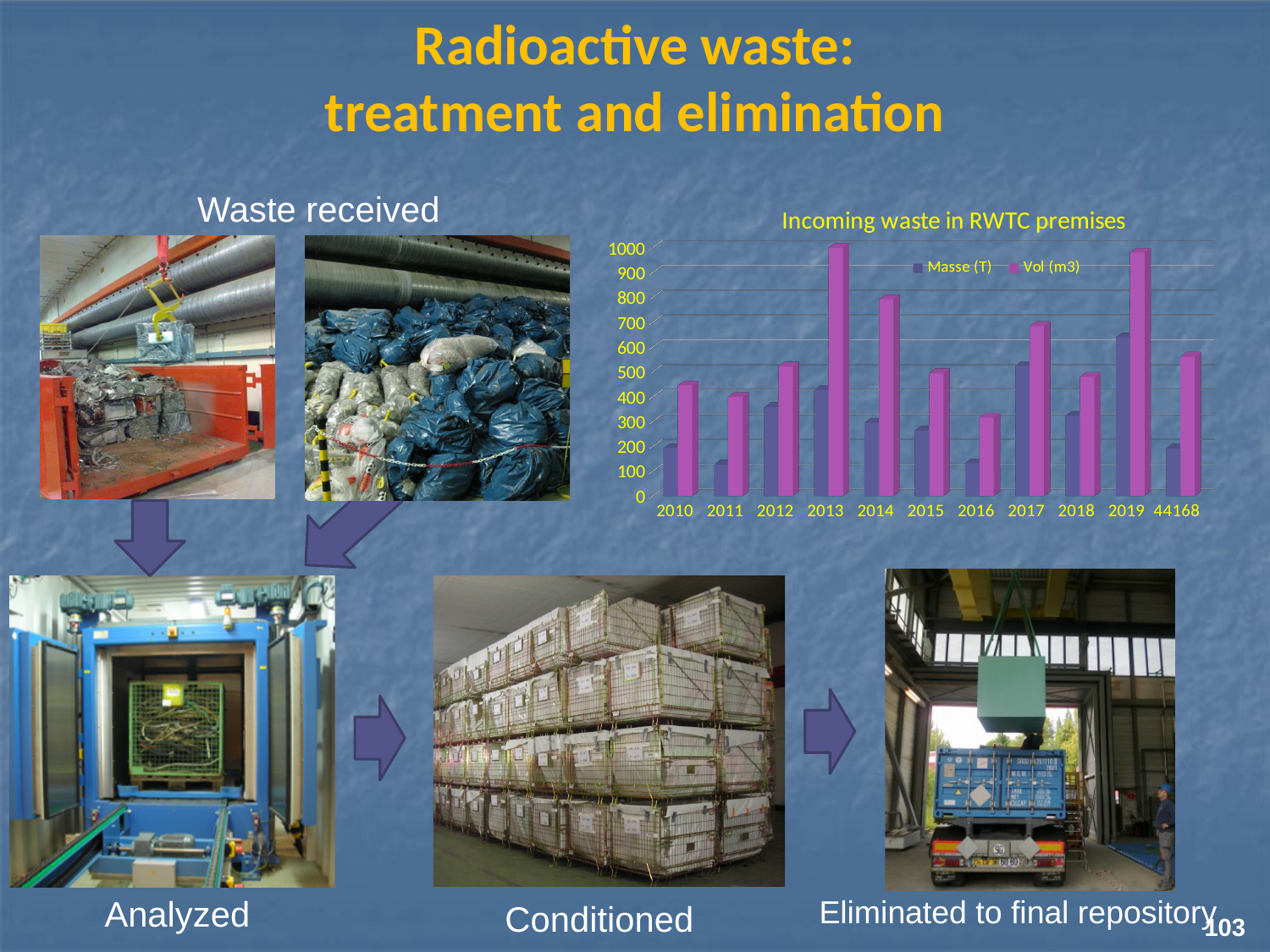
What kind of chart is shown on the slide? bar chart Is the Masse (T) value for 2011 greater or less than 200? less Which year has the lowest Vol (m3) value? 2016 Which is larger, the Vol (m3) value for 2014 or for 2017? 2014 How many series does the chart legend list? 2 Which series is shown in magenta in the chart? Vol (m3) Is the Vol (m3) value for 2016 greater or less than 400? less Which year has the highest Masse (T) value? 2019 How many categories are shown along the x axis of the chart? 11 What is the title of the chart? Incoming waste in RWTC premises Is the Vol (m3) value for 2013 greater or less than 900? greater Which is larger, the Masse (T) value for 2012 or for 2016? 2012